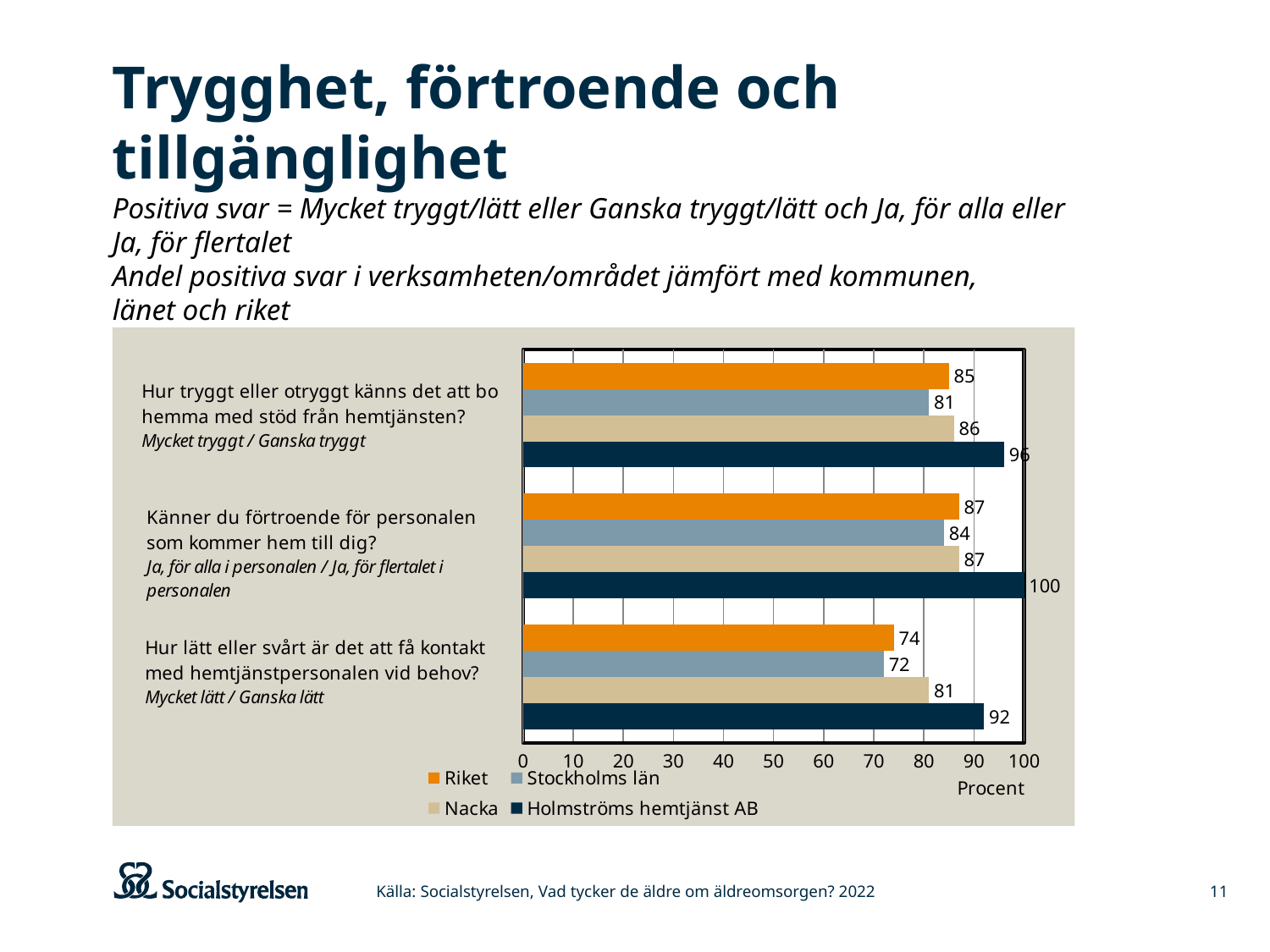
What is the value for Holmströms hemtjänst AB on the question "Känner du förtroende för personalen som kommer hem till dig?"? 100 How many series does the legend list? 4 How many questions (categories) are plotted in the chart? 3 What kind of chart is shown on the slide? Bar chart Is the value for Holmströms hemtjänst AB on the question "Hur tryggt eller otryggt känns det att bo hemma med stöd från hemtjänsten?" greater or less than 90? greater What is the difference between Holmströms hemtjänst AB and Riket on the question "Hur lätt eller svårt är det att få kontakt med hemtjänstpersonalen vid behov?"? 18 What is the value for Stockholms län on the question "Hur lätt eller svårt är det att få kontakt med hemtjänstpersonalen vid behov?"? 72 What is the label of the horizontal axis? Procent Which series has the lowest value on the question "Känner du förtroende för personalen som kommer hem till dig?"? Stockholms län What is the value for Riket on the question "Hur tryggt eller otryggt känns det att bo hemma med stöd från hemtjänsten?"? 85 What is the value for Nacka on the question "Hur lätt eller svårt är det att få kontakt med hemtjänstpersonalen vid behov?"? 81 Which series has the highest value on the question "Hur lätt eller svårt är det att få kontakt med hemtjänstpersonalen vid behov?"? Holmströms hemtjänst AB